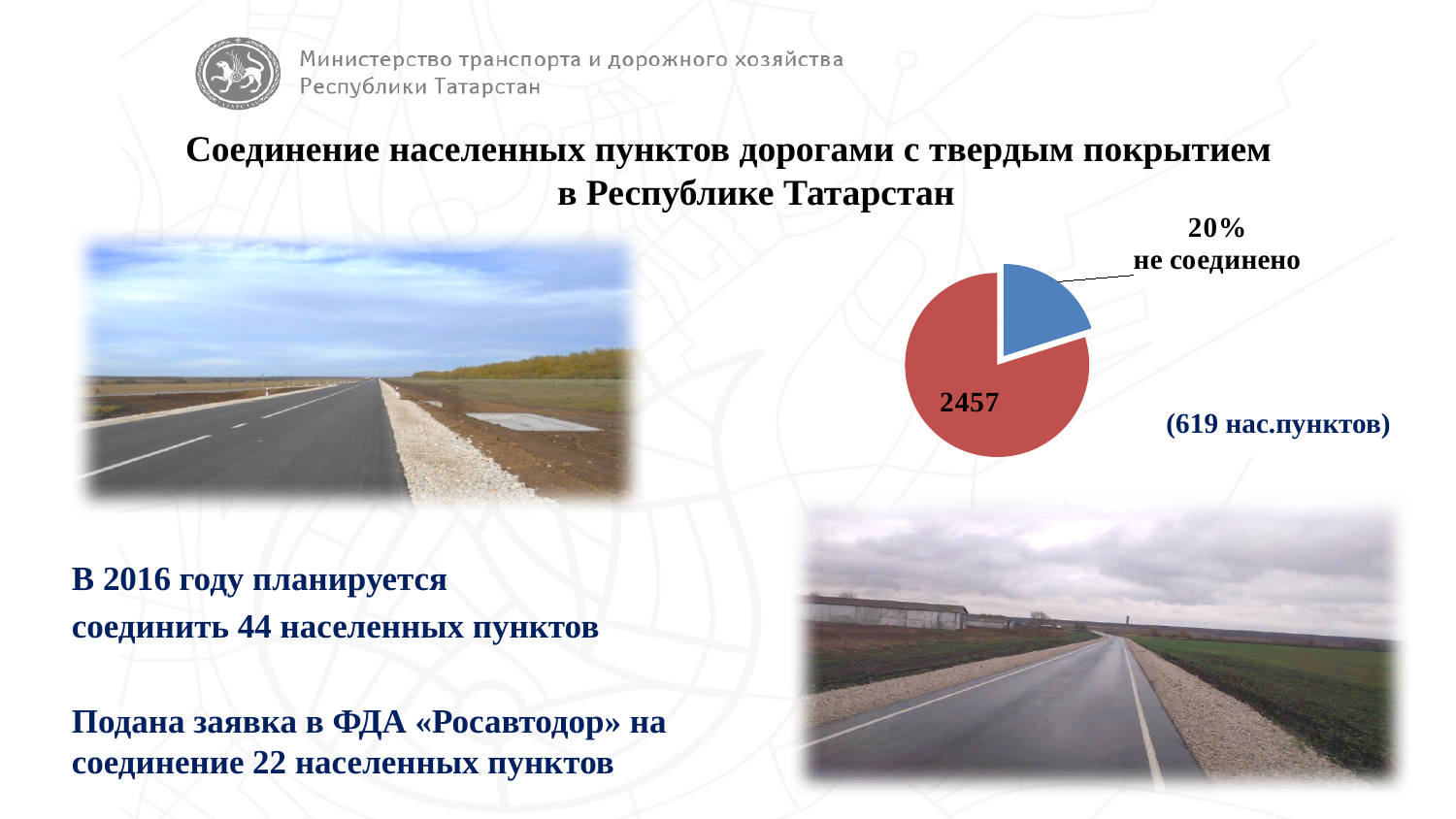
How many settlements (нас.пунктов) are shown as 'не соединено' in the pie chart? 619 How many slices does the pie chart have? 2 What value is printed on the large red slice of the pie chart? 2457 What kind of chart is shown on the slide? pie chart What is the total of the two values shown in the pie chart, 2457 and 619? 3076 Which slice of the pie chart is larger: the red slice (2457) or the blue 'не соединено' slice? the red slice (2457) What is the difference between the two values shown in the pie chart, 2457 and 619? 1838 What percentage share is labelled for the 'не соединено' slice of the pie chart? 20% What is the title of the slide containing the pie chart? Соединение населенных пунктов дорогами с твердым покрытием в Республике Татарстан What colour is the 'не соединено' slice of the pie chart? blue